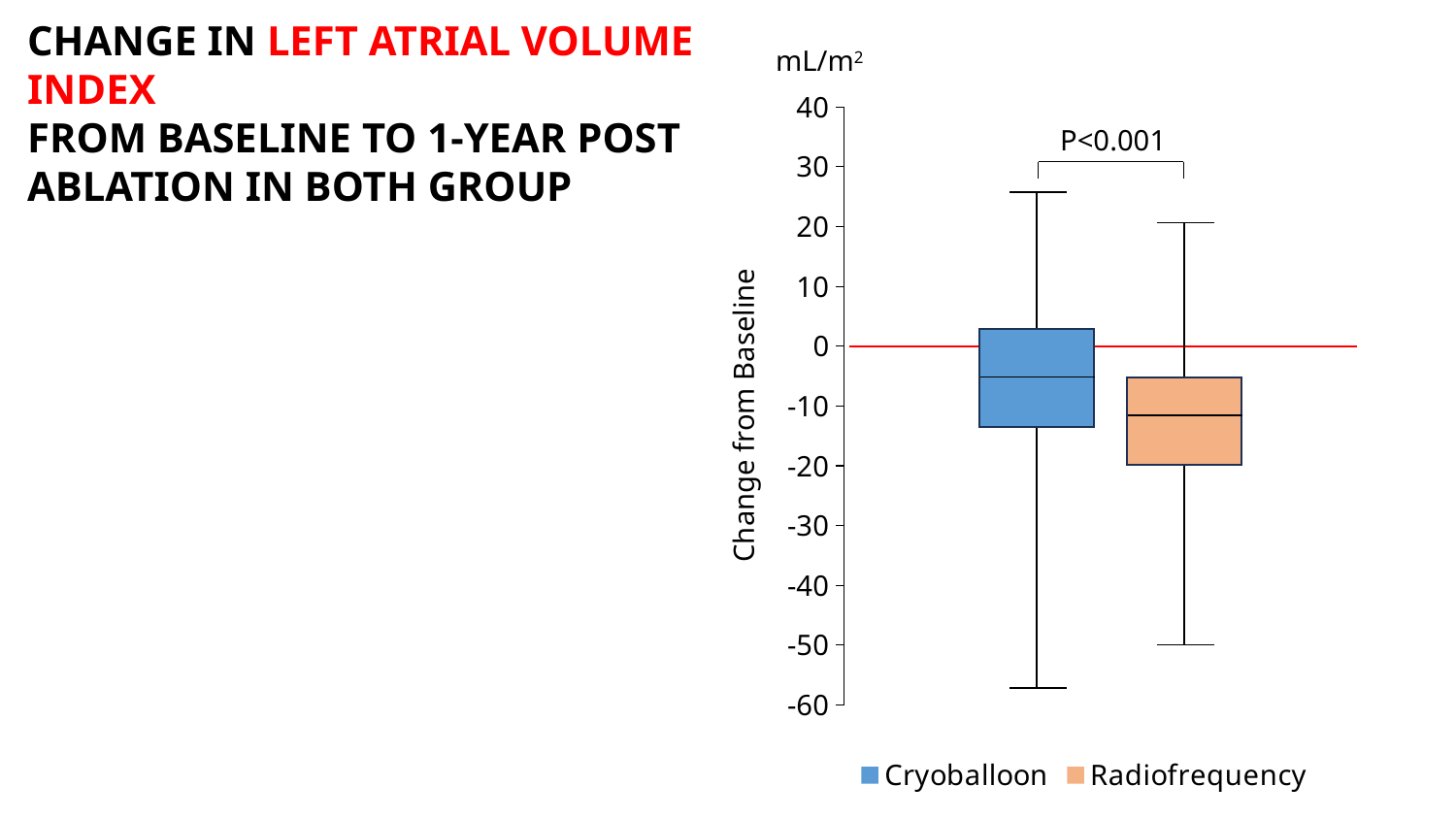
Which group's lower whisker extends further below zero, Cryoballoon or Radiofrequency? Cryoballoon Which group has the lower median change from baseline, Cryoballoon or Radiofrequency? Radiofrequency What kind of chart is shown on the slide? Box-and-whisker plot What p-value is annotated between the two boxes? P<0.001 Is the bottom of the Radiofrequency box greater or less than -10? less How many boxes are plotted in the chart? 2 Is the upper whisker of the Cryoballoon box greater or less than 20? greater Is the median change from baseline for Cryoballoon greater or less than 0? less How many groups does the legend list? 2 What unit is shown above the y axis of the chart? mL/m²